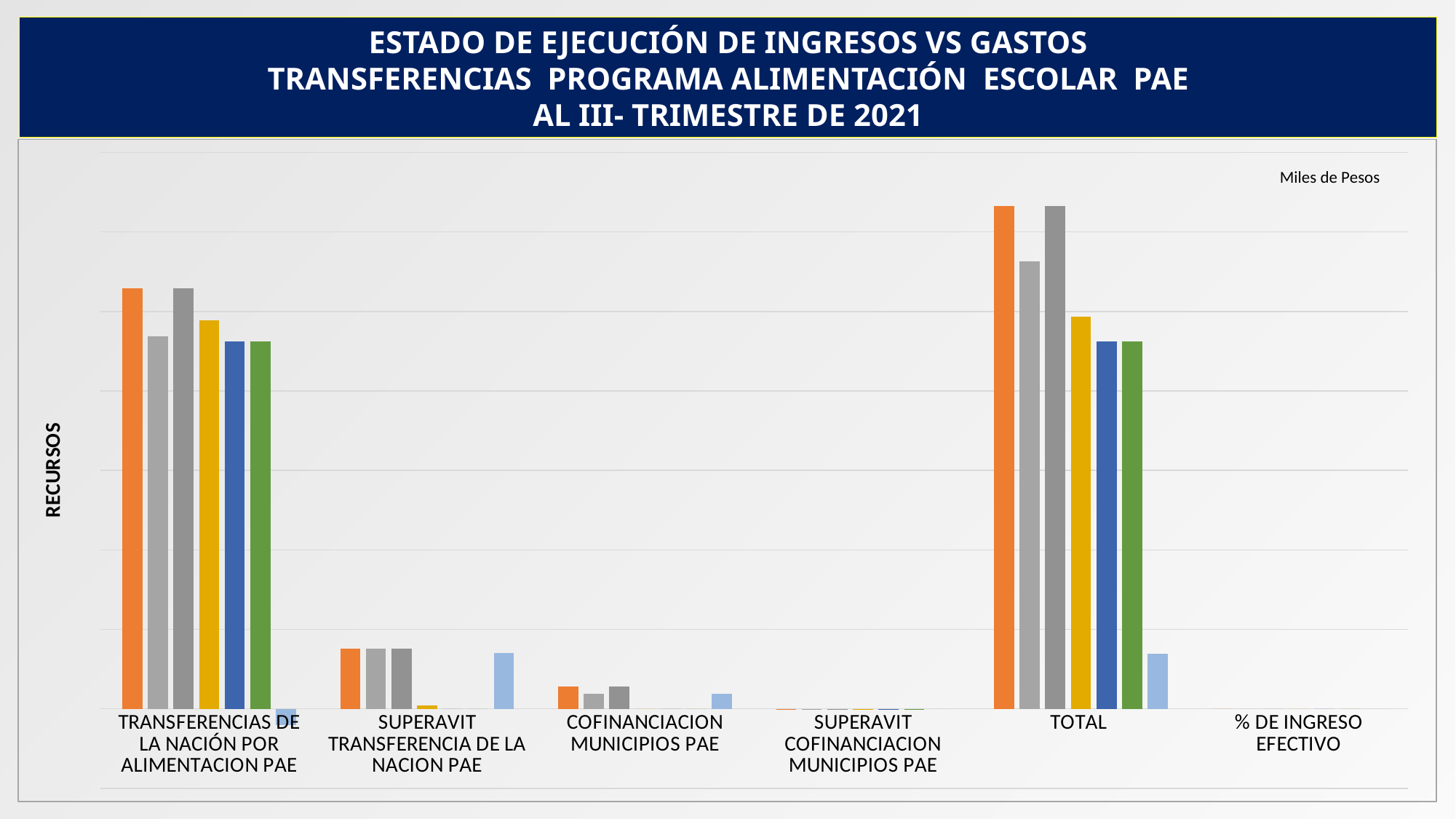
What kind of chart is shown on the slide? bar chart Which category shows no visible bars in the chart? % DE INGRESO EFECTIVO What is the title of the vertical axis of the chart? RECURSOS What unit note is printed in the top right corner of the chart area? Miles de Pesos Which category has taller bars, SUPERAVIT TRANSFERENCIA DE LA NACION PAE or COFINANCIACION MUNICIPIOS PAE? SUPERAVIT TRANSFERENCIA DE LA NACION PAE Which category has the tallest bar in the chart? TOTAL Which category is larger, TRANSFERENCIAS DE LA NACIÓN POR ALIMENTACION PAE or COFINANCIACION MUNICIPIOS PAE? TRANSFERENCIAS DE LA NACIÓN POR ALIMENTACION PAE Which category has taller bars, TOTAL or SUPERAVIT TRANSFERENCIA DE LA NACION PAE? TOTAL How many bars are plotted in the TOTAL category group? 7 How many categories are shown along the x axis of the chart? 6